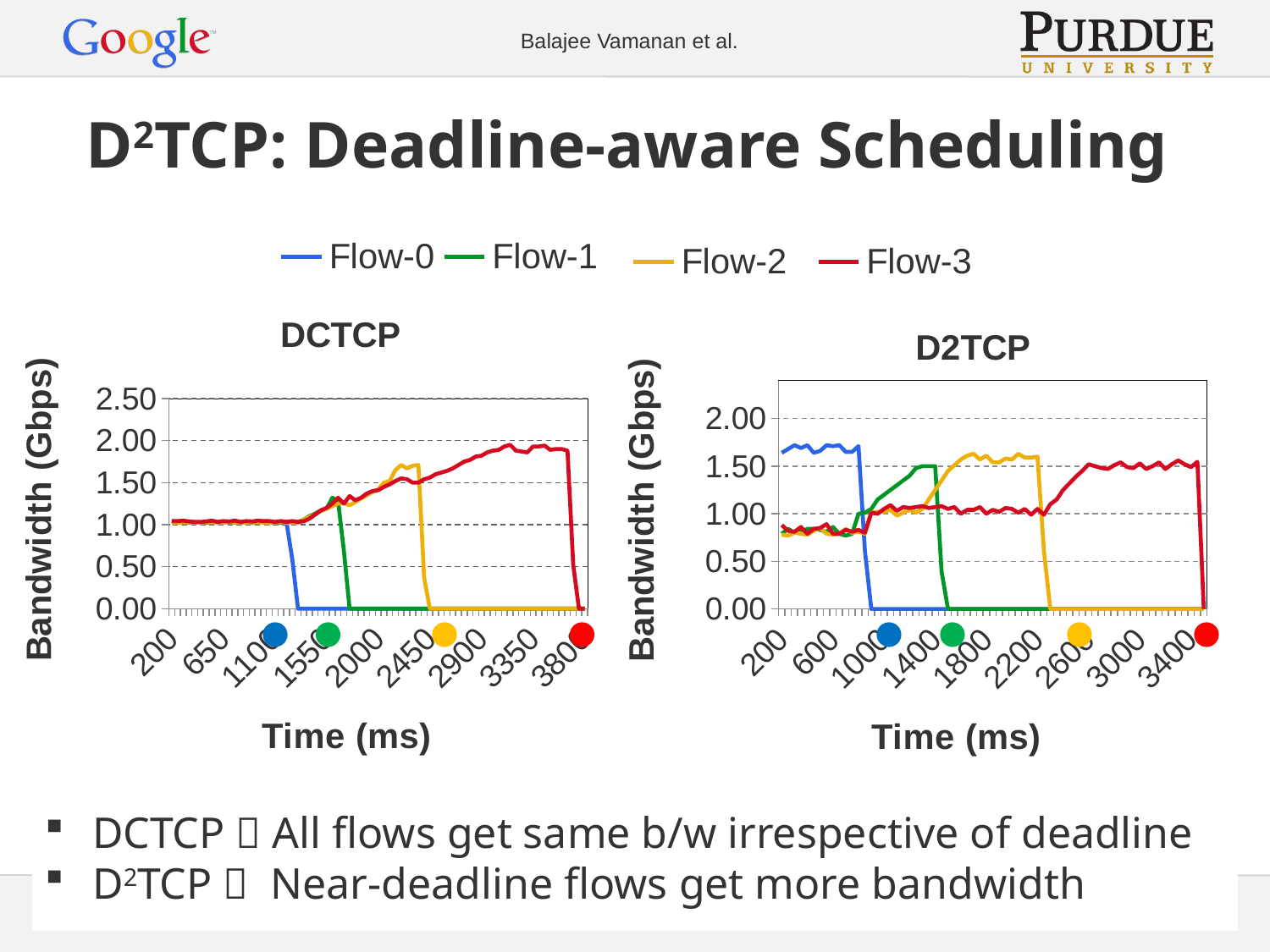
In the DCTCP chart, is the peak bandwidth of Flow-3 greater or less than 2.00? less In the D2TCP chart, at 600 ms, which has the larger bandwidth, Flow-0 or Flow-1? Flow-0 In the D2TCP chart, which flow has the highest bandwidth at 600 ms? Flow-0 What kind of chart is the DCTCP chart? line chart In the DCTCP chart, does the bandwidth of Flow-3 rise or fall between 1550 ms and 3350 ms? rise What is the y-axis label of the DCTCP chart? Bandwidth (Gbps) In the D2TCP chart, is the bandwidth of Flow-0 at 600 ms greater or less than 1.50? greater How many tick labels are shown on the x axis of the D2TCP chart? 9 In the D2TCP chart, is the bandwidth of Flow-3 at 600 ms greater or less than 1.00? less What is the title of the chart on the right? D2TCP How many series does the shared legend list? 4